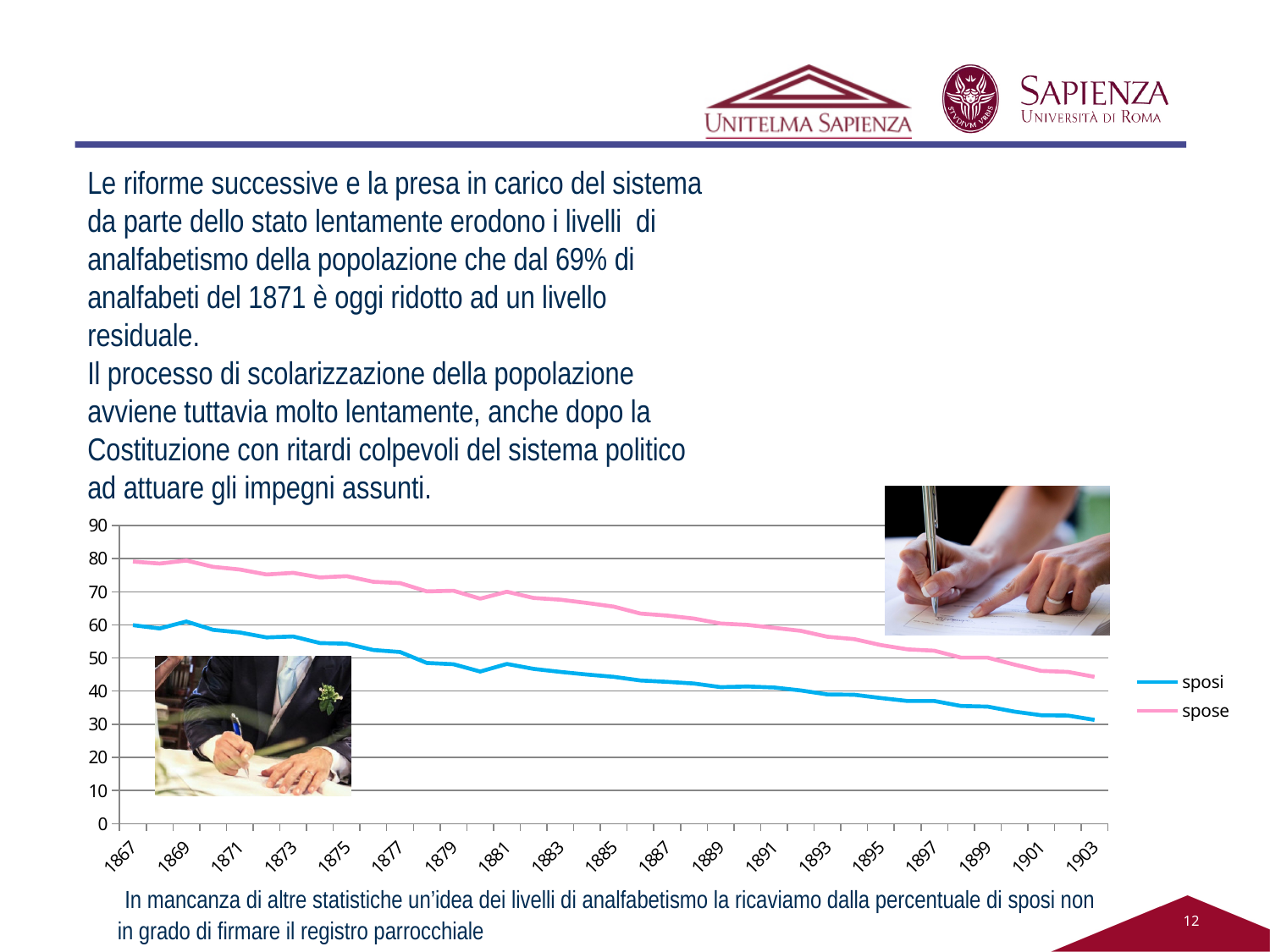
Is the value for 'sposi' in 1903 greater or less than 40? less In which year does the 'sposi' series reach its lowest value? 1903 What kind of chart is shown on the slide? line chart Which series has the higher value in 1903, 'sposi' or 'spose'? spose What are the two series named in the chart legend? sposi and spose Which colour is used for the 'spose' line in the chart? pink Do the values of the 'sposi' series rise or fall from 1867 to 1903? fall Which series has the higher value in 1867, 'sposi' or 'spose'? spose How many series does the chart legend list? 2 Is the value for 'spose' in 1867 greater or less than 70? greater Is the value for 'sposi' in 1885 greater or less than 50? less Do the values of the 'spose' series rise or fall from 1867 to 1903? fall